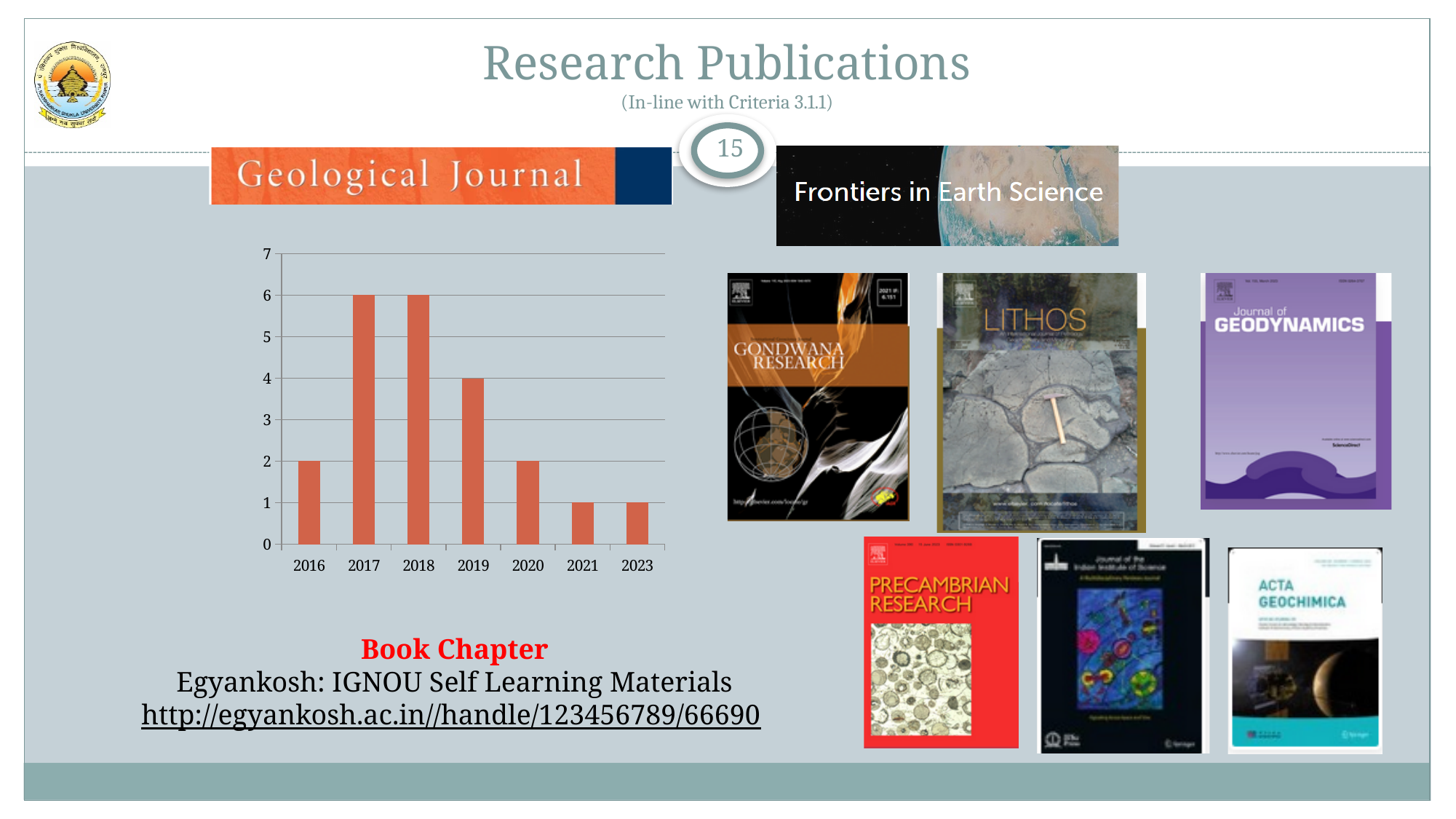
Which year has the highest value in the bar chart, 2019 or 2018? 2018 How many years are shown on the x axis of the bar chart? 7 What is the value for 2016 in the bar chart? 2 What is the difference between the values for 2018 and 2020 in the bar chart? 4 What kind of chart is shown on the slide? bar chart What is the highest value shown on the y axis of the bar chart? 7 Do the values in the bar chart rise or fall from 2018 to 2023? fall What is the value for 2019 in the bar chart? 4 Is the value for 2019 in the bar chart greater or less than 3? greater What is the value for 2021 in the bar chart? 1 What is the value for 2017 in the bar chart? 6 Which year has the lowest value in the bar chart, 2020 or 2023? 2023